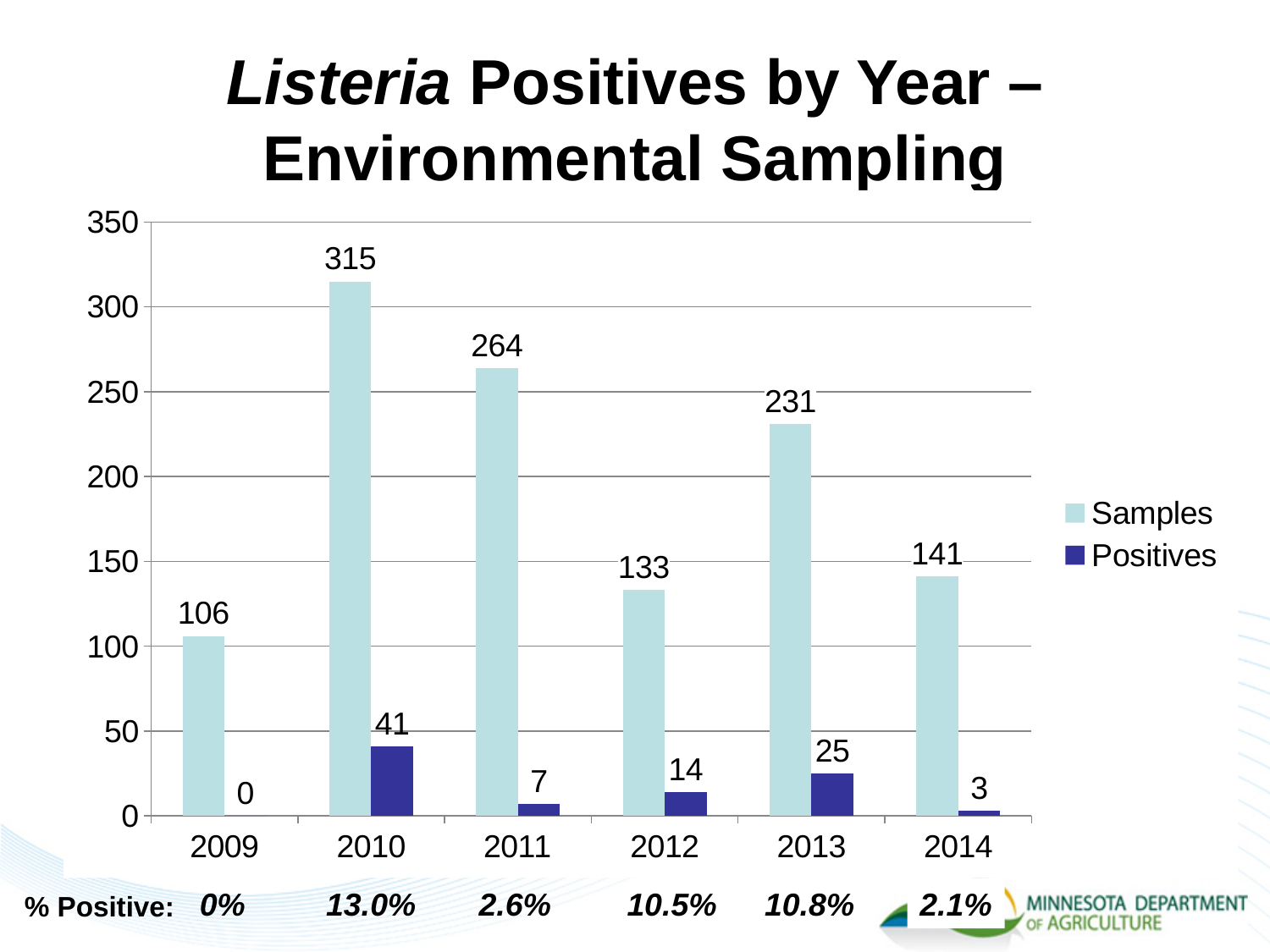
Is the number of Samples in 2013 greater or less than 200? greater Which series is shown in dark blue in the legend? Positives Which year had more Positives, 2012 or 2014? 2012 How many Samples were taken in 2010? 315 Which year had the highest number of Samples? 2010 How many years are shown on the x axis? 6 What kind of chart is shown on the slide? bar chart How many series does the legend list? 2 What is the difference between the number of Samples in 2011 and in 2012? 131 Which year had the lowest number of Positives? 2009 How many Positives were recorded in 2013? 25 What is the % Positive shown for 2010? 13.0%